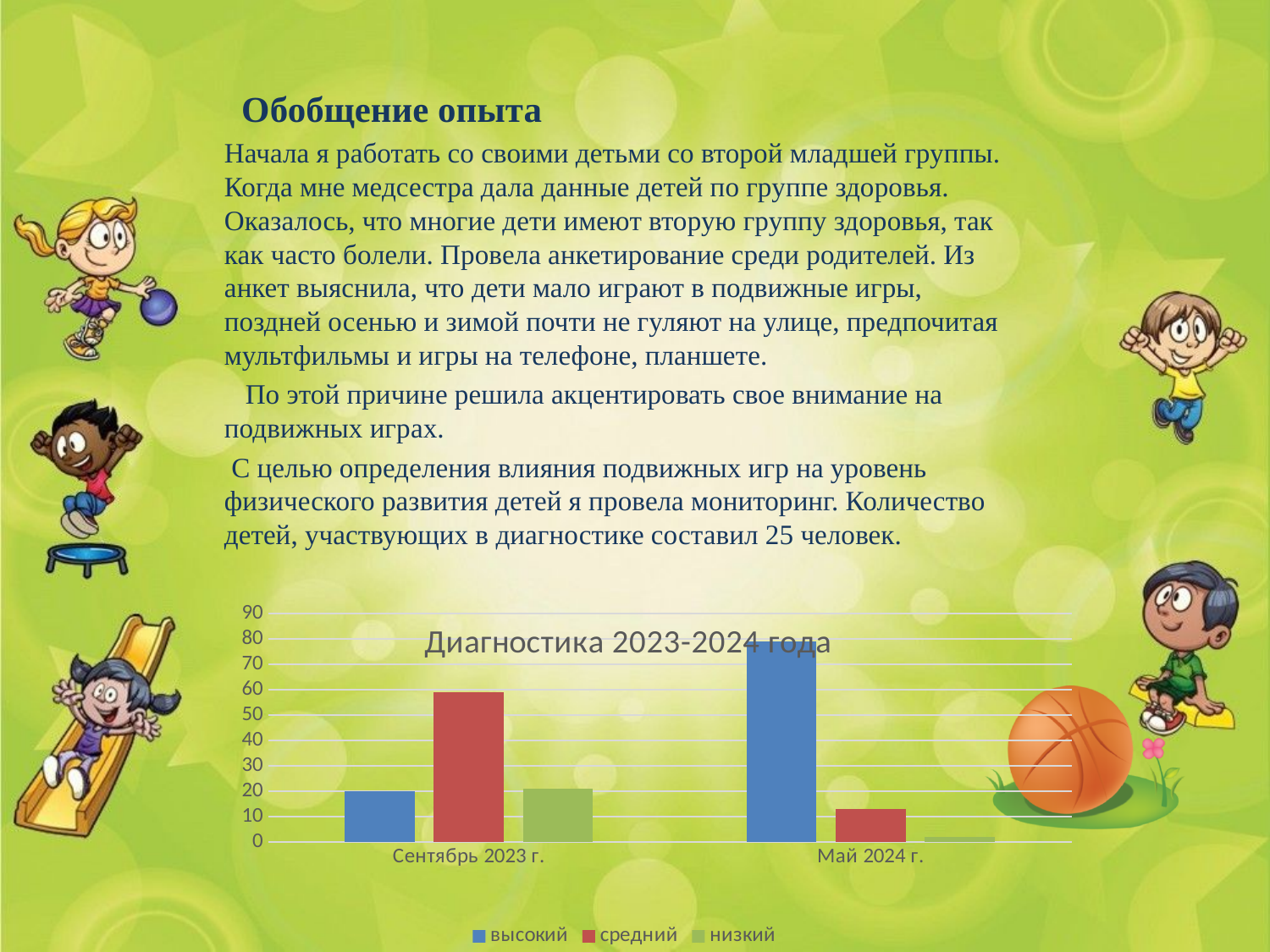
Which is larger: the value for средний in Сентябрь 2023 г. or in Май 2024 г.? Сентябрь 2023 г. What is the title of the chart? Диагностика 2023-2024 года Is the value for высокий in Май 2024 г. greater or less than 70? greater Does the value for высокий rise or fall from Сентябрь 2023 г. to Май 2024 г.? rise What kind of chart is shown on the slide? bar chart Which series has the highest value for Сентябрь 2023 г.? средний How many series does the chart legend list? 3 How many categories are shown on the x axis of the chart? 2 Which series has the highest value for Май 2024 г.? высокий Is the value for высокий in Сентябрь 2023 г. greater or less than 30? less Is the value for средний in Сентябрь 2023 г. greater or less than 50? greater Which series has the lowest value for Май 2024 г.? низкий